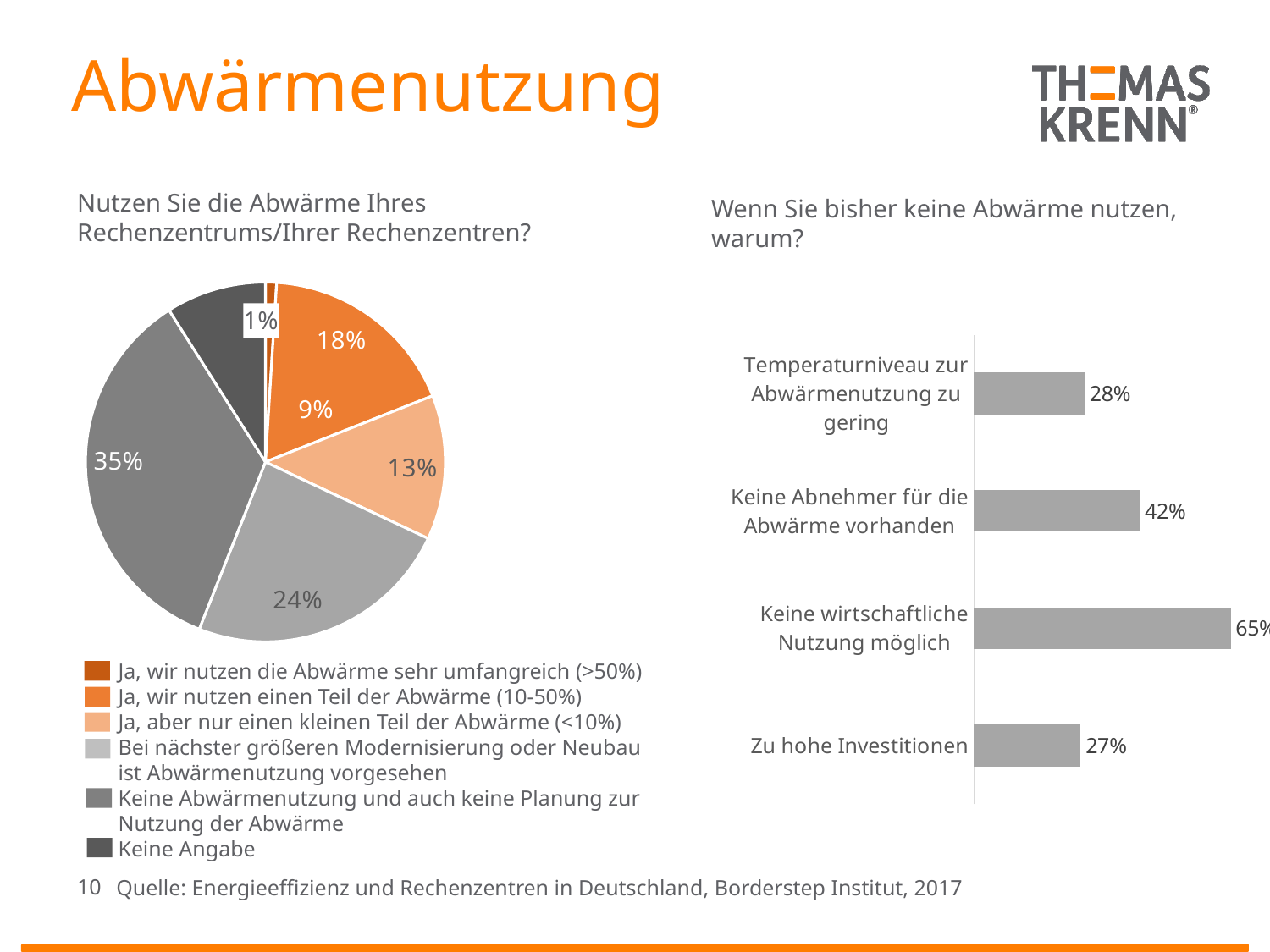
In the bar chart on the right, which category has the lowest value? Zu hohe Investitionen In the bar chart on the right, what is the value for 'Temperaturniveau zur Abwärmenutzung zu gering'? 28% In the pie chart on the left, what share is shown for 'Ja, wir nutzen einen Teil der Abwärme (10-50%)'? 18% In the bar chart on the right, what is the difference between 'Keine wirtschaftliche Nutzung möglich' and 'Keine Abnehmer für die Abwärme vorhanden'? 23% In the pie chart on the left, which category has the largest slice? Keine Abwärmenutzung und auch keine Planung zur Nutzung der Abwärme In the bar chart 'Wenn Sie bisher keine Abwärme nutzen, warum?', what is the value for 'Keine wirtschaftliche Nutzung möglich'? 65% In the pie chart on the left, which category has the smallest slice? Ja, wir nutzen die Abwärme sehr umfangreich (>50%) What type of chart is shown on the right side of the slide? Bar chart In the pie chart 'Nutzen Sie die Abwärme Ihres Rechenzentrums/Ihrer Rechenzentren?', what share is shown for 'Keine Abwärmenutzung und auch keine Planung zur Nutzung der Abwärme'? 35% In the bar chart on the right, how many categories are shown? 4 How many categories does the legend of the pie chart on the left list? 6 In the pie chart on the left, what share is shown for 'Bei nächster größeren Modernisierung oder Neubau ist Abwärmenutzung vorgesehen'? 24%